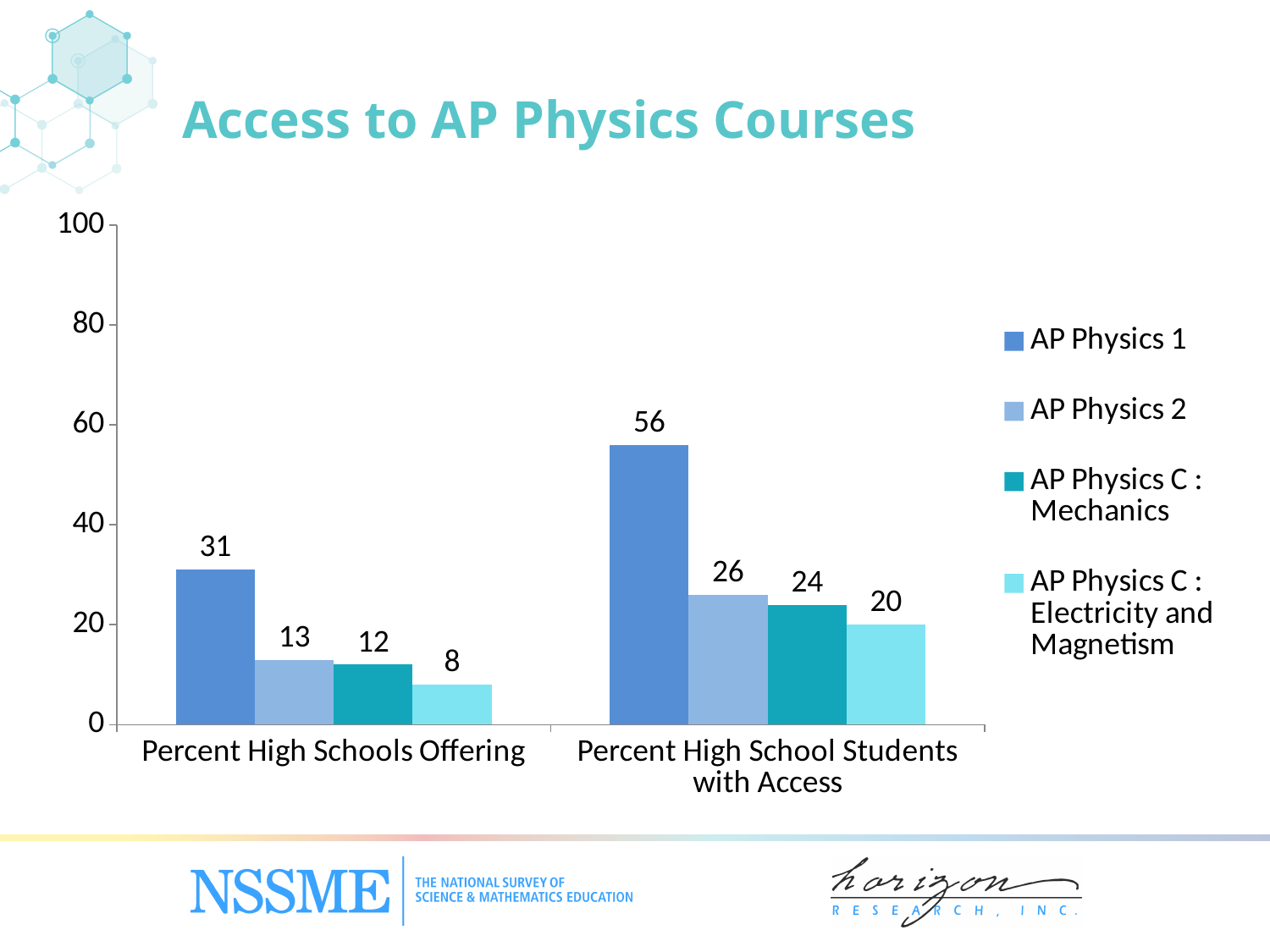
Which series has the lowest value in the Percent High Schools Offering category? AP Physics C : Electricity and Magnetism What is the value for AP Physics C : Electricity and Magnetism in the Percent High School Students with Access category? 20 What is the difference between the AP Physics 1 values for Percent High School Students with Access and Percent High Schools Offering? 25 How many series does the legend list? 4 Which series has the highest value in the Percent High School Students with Access category? AP Physics 1 What is the value for AP Physics 2 in the Percent High School Students with Access category? 26 How many categories are shown on the x axis? 2 What is the difference between AP Physics 2 and AP Physics C : Mechanics in the Percent High School Students with Access category? 2 Is the value for AP Physics 1 in the Percent High School Students with Access category greater or less than 60? less What is the value for AP Physics 1 in the Percent High Schools Offering category? 31 Which is larger: AP Physics 2 in Percent High Schools Offering or AP Physics C : Electricity and Magnetism in Percent High School Students with Access? AP Physics C : Electricity and Magnetism in Percent High School Students with Access What kind of chart is shown on the slide? Bar chart